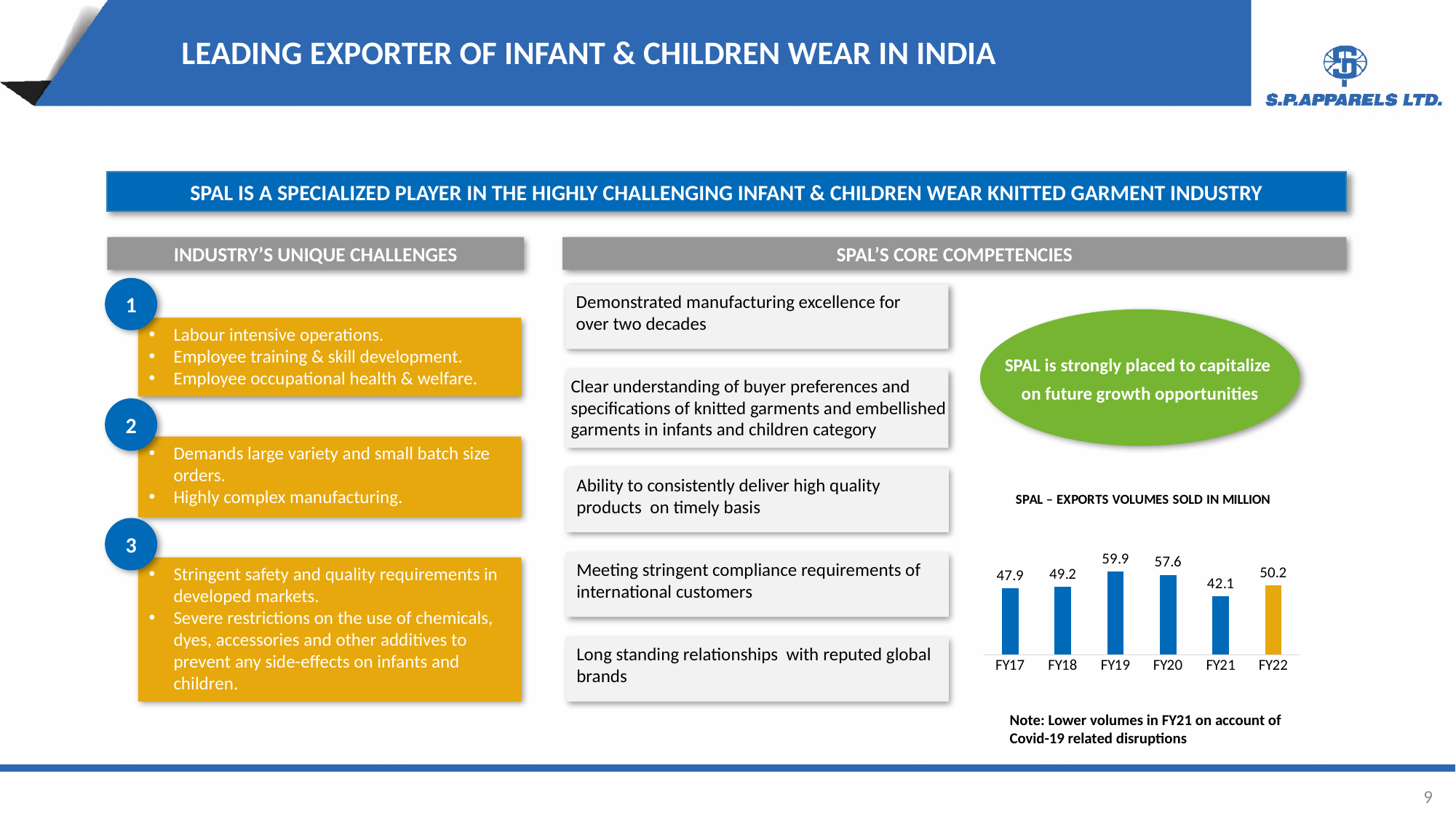
What is the export volume sold for FY22? 50.2 What is the difference between the export volumes for FY19 and FY21? 17.8 How many fiscal years are shown on the chart? 6 Which is larger, the export volume for FY18 or FY20? FY20 What is the difference between the export volumes for FY22 and FY21? 8.1 Did the export volume rise or fall from FY20 to FY21? Fall Which fiscal year has the highest export volume? FY19 What is the title of the chart? SPAL – EXPORTS VOLUMES SOLD IN MILLION What kind of chart is used to show the export volumes? Bar chart What is the export volume sold for FY17? 47.9 Which fiscal year has the lowest export volume? FY21 What is the export volume sold for FY19? 59.9